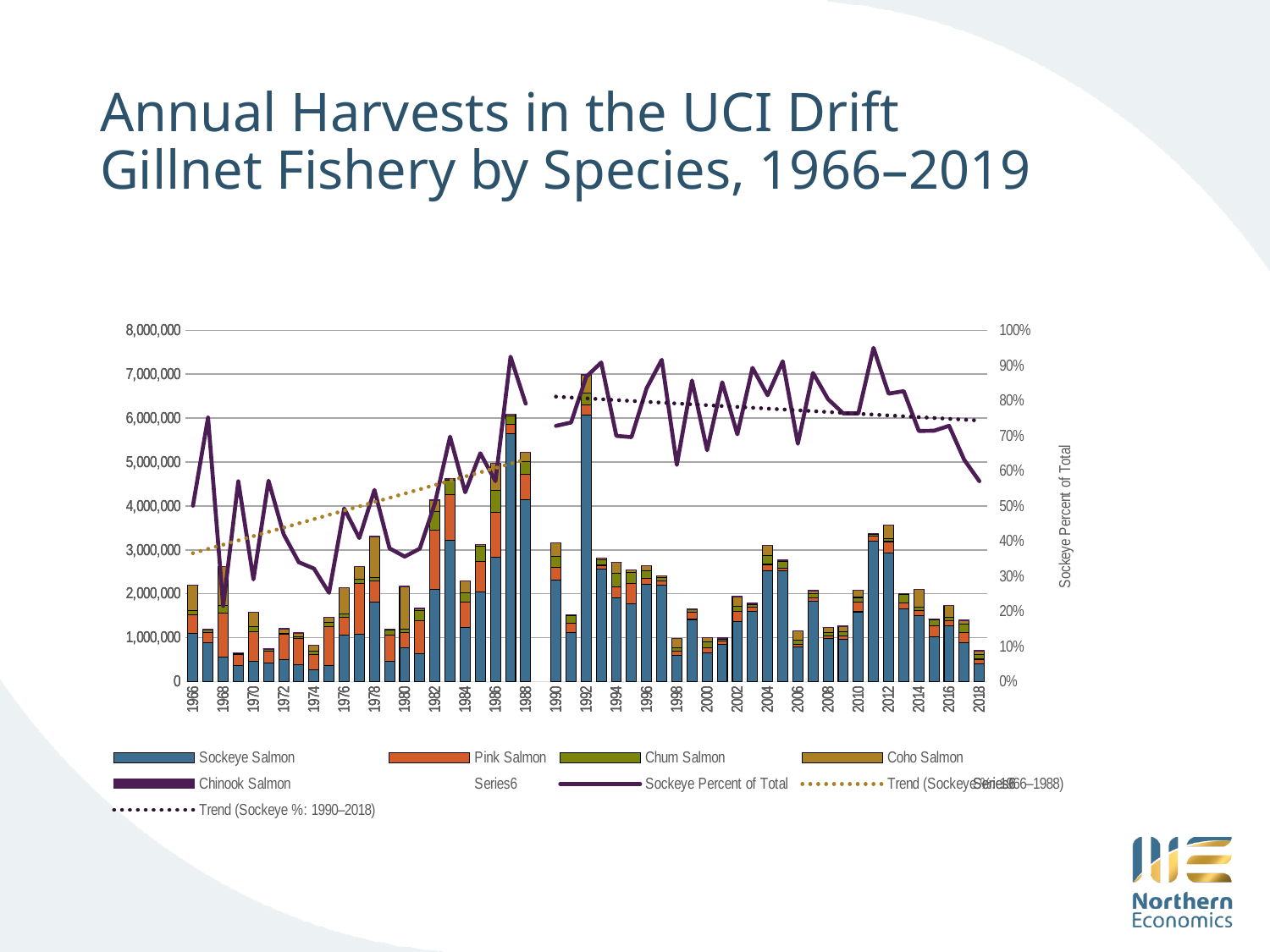
Is the total harvest for 1966 greater or less than 2,000,000? greater Is the Sockeye Percent of Total for 2018 greater or less than 60%? less Which year has the highest total harvest bar? 1992 What is the title of the right-hand vertical axis? Sockeye Percent of Total Is the Sockeye Percent of Total for 1969 greater or less than 30%? greater Does the Trend (Sockeye %: 1966–1988) line rise or fall from left to right? rise Does the Trend (Sockeye %: 1990–2018) line rise or fall from left to right? fall Which year has the larger total harvest, 1983 or 1984? 1983 What kind of chart is shown on the slide? combination bar and line chart